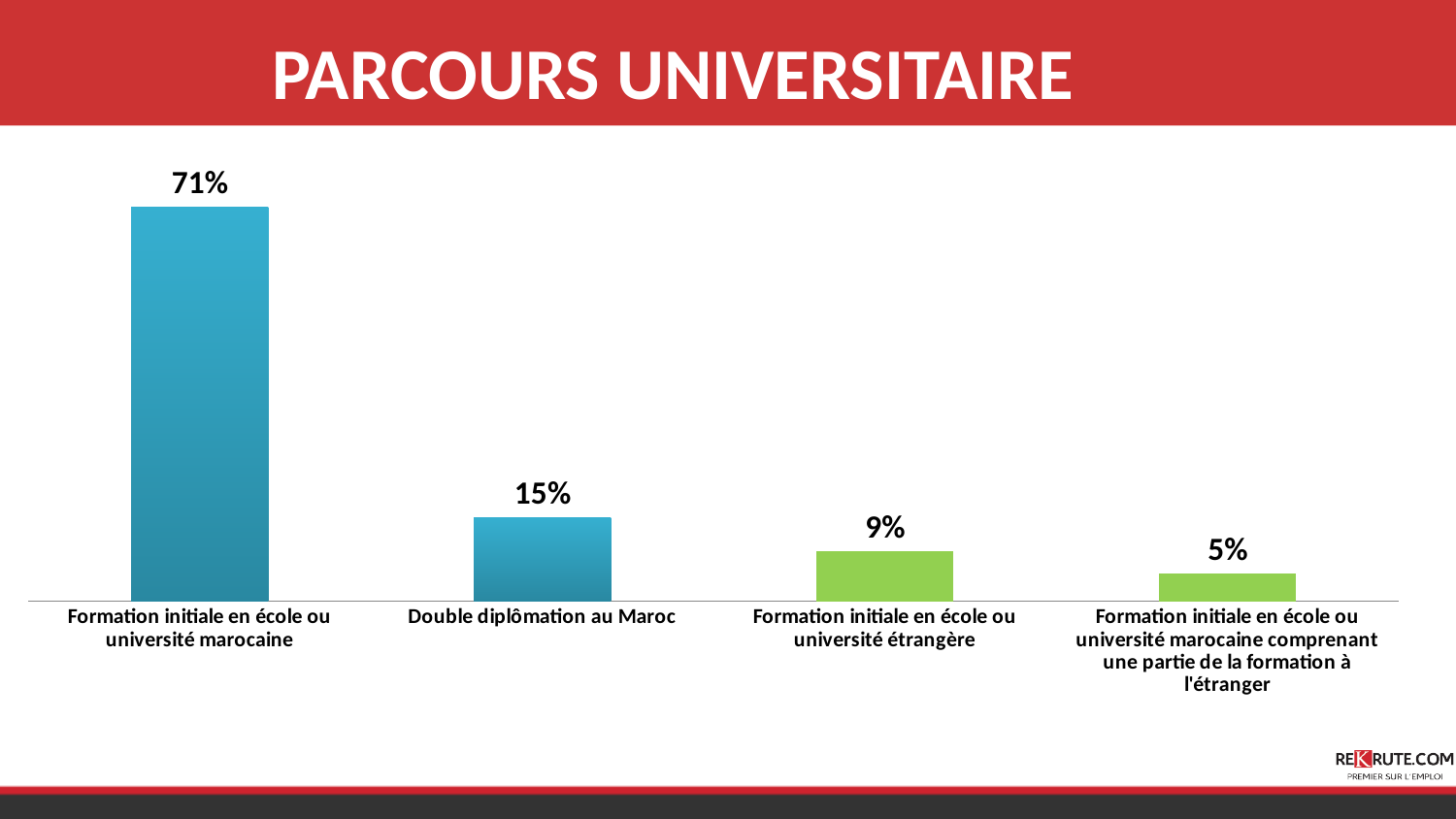
What is the value for "Formation initiale en école ou université marocaine"? 71% Which category has the highest value? Formation initiale en école ou université marocaine What is the value for "Formation initiale en école ou université marocaine comprenant une partie de la formation à l'étranger"? 5% What is the difference between the values for "Formation initiale en école ou université étrangère" and "Formation initiale en école ou université marocaine comprenant une partie de la formation à l'étranger"? 4% What is the value for "Double diplômation au Maroc"? 15% What is the title of the slide? PARCOURS UNIVERSITAIRE What kind of chart is shown on the slide? Bar chart What is the difference between the values for "Formation initiale en école ou université marocaine" and "Double diplômation au Maroc"? 56% Which category has the lowest value? Formation initiale en école ou université marocaine comprenant une partie de la formation à l'étranger Which is larger: the value for "Double diplômation au Maroc" or the value for "Formation initiale en école ou université étrangère"? Double diplômation au Maroc What is the value for "Formation initiale en école ou université étrangère"? 9% How many categories are shown in the chart? 4